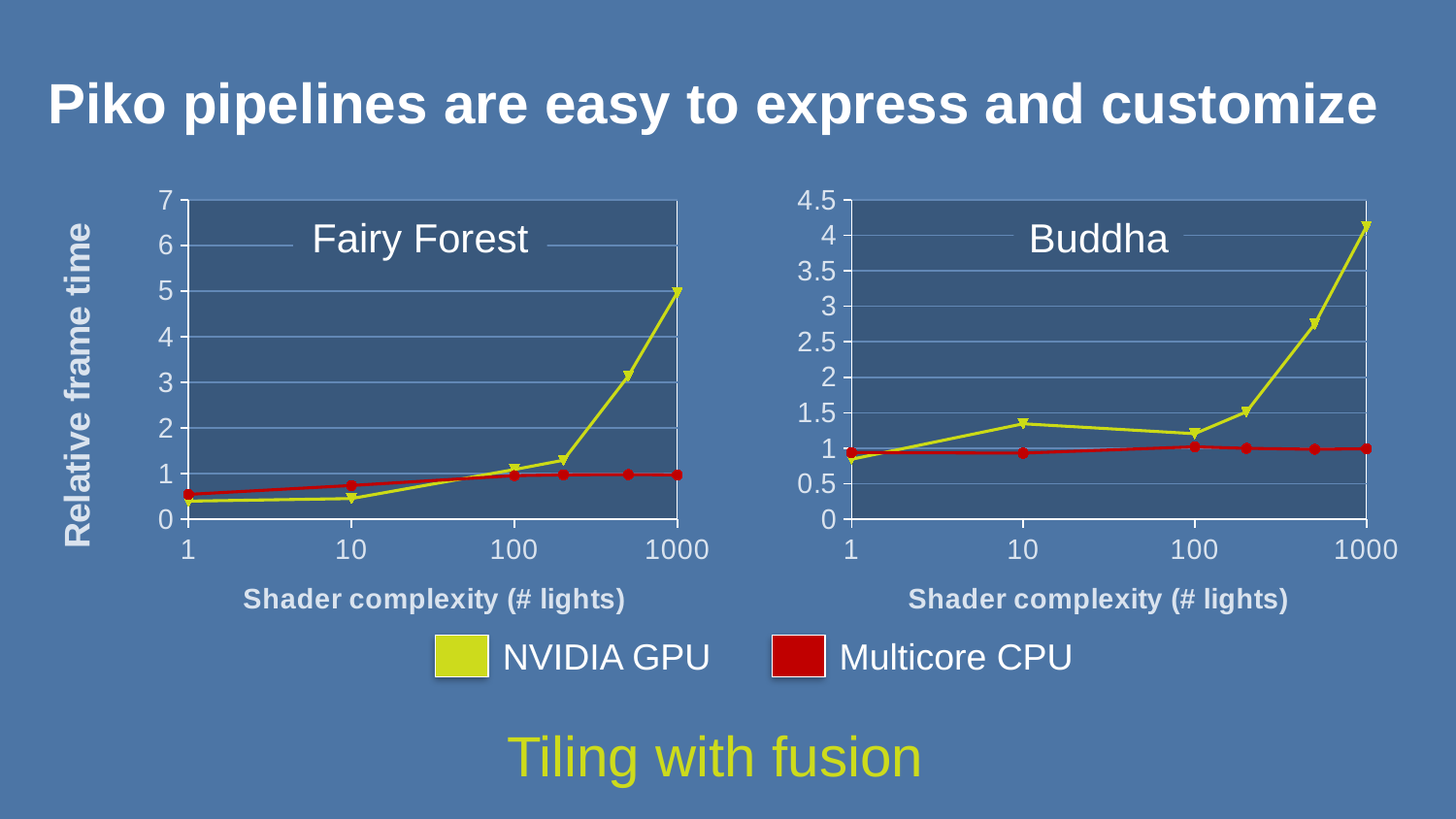
In the Fairy Forest chart, is the Multicore CPU value at 1000 lights greater or less than 2? less What kind of chart is the Fairy Forest chart? line chart In the Fairy Forest chart, is the NVIDIA GPU value at 1000 lights greater or less than 4? greater What is the x-axis title of the Buddha chart? Shader complexity (# lights) In the Buddha chart, is the NVIDIA GPU value at 1000 lights greater or less than 3.5? greater How many tick labels are shown on the x axis of the Fairy Forest chart? 4 How many series does the legend list? 2 In the Buddha chart, which series has the higher value at 1000 lights? NVIDIA GPU In the Fairy Forest chart, does the NVIDIA GPU line rise or fall from 100 lights to 1000 lights? rise In the Fairy Forest chart, which series has the higher value at 1000 lights? NVIDIA GPU